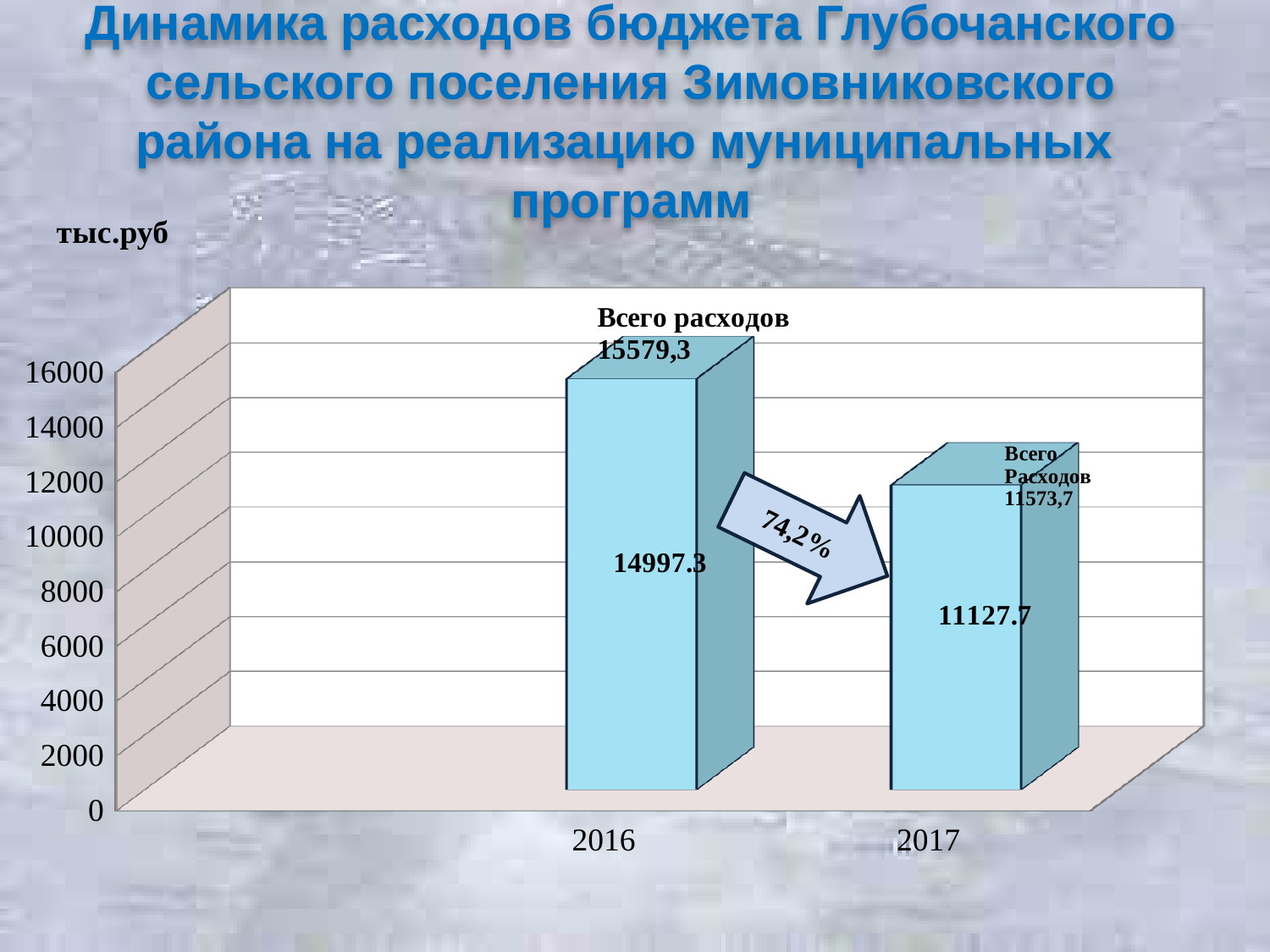
Is the value for 2017 greater or less than 12000? less What is the difference between the 2016 value and the 2017 value? 3869.6 What total expenditure (Всего расходов) figure is printed above the 2016 bar? 15579,3 Which year has the lowest value on the chart? 2017 Which year has the higher bar, 2016 or 2017? 2016 What is the value of the bar for 2017? 11127.7 What is the value of the bar for 2016? 14997.3 What percentage is written on the arrow between the two bars? 74,2% Is the value for 2016 greater or less than 14000? greater How many years (categories) are shown on the x axis? 2 Do the values rise or fall from 2016 to 2017? fall What kind of chart is shown on the slide? bar chart